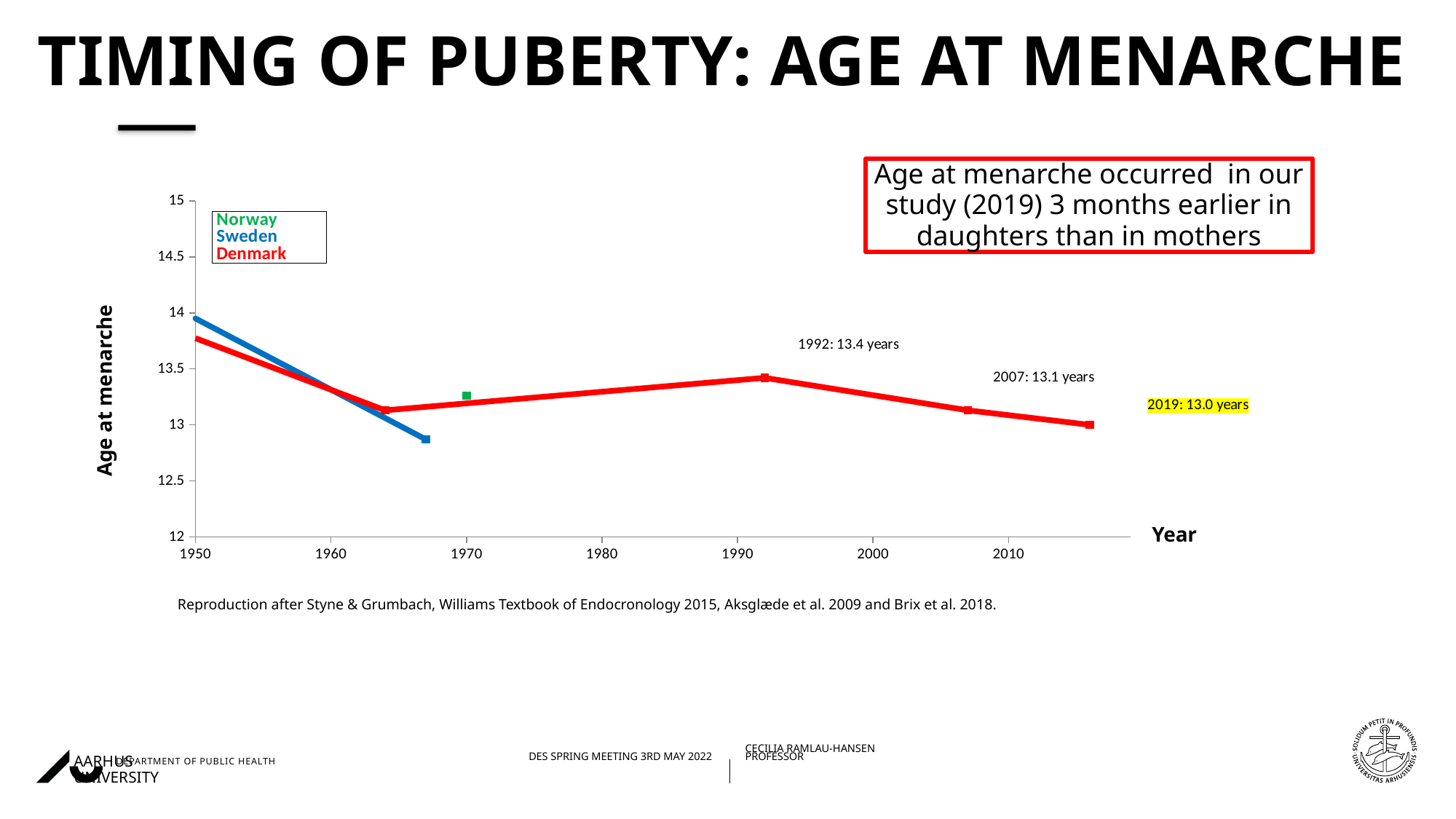
What is the difference between the Danish age at menarche in 2007 and in 2019? 0.1 years Which year had the higher Danish age at menarche, 1992 or 2007? 1992 By how much did the Danish age at menarche fall between 1992 and 2019? 0.4 years What is the label on the y axis of the chart? Age at menarche Is the value for Norway (around 1970) greater or less than 13? greater What kind of chart is shown on the slide? line chart Is the value for Sweden at its last point (around 1967) greater or less than 13? less What was the age at menarche in Denmark in 2007? 13.1 years What was the age at menarche in Denmark in 1992? 13.4 years Does the Danish age at menarche rise or fall from 1992 to 2019? fall How many countries does the legend list? 3 What was the age at menarche in Denmark in 2019? 13.0 years